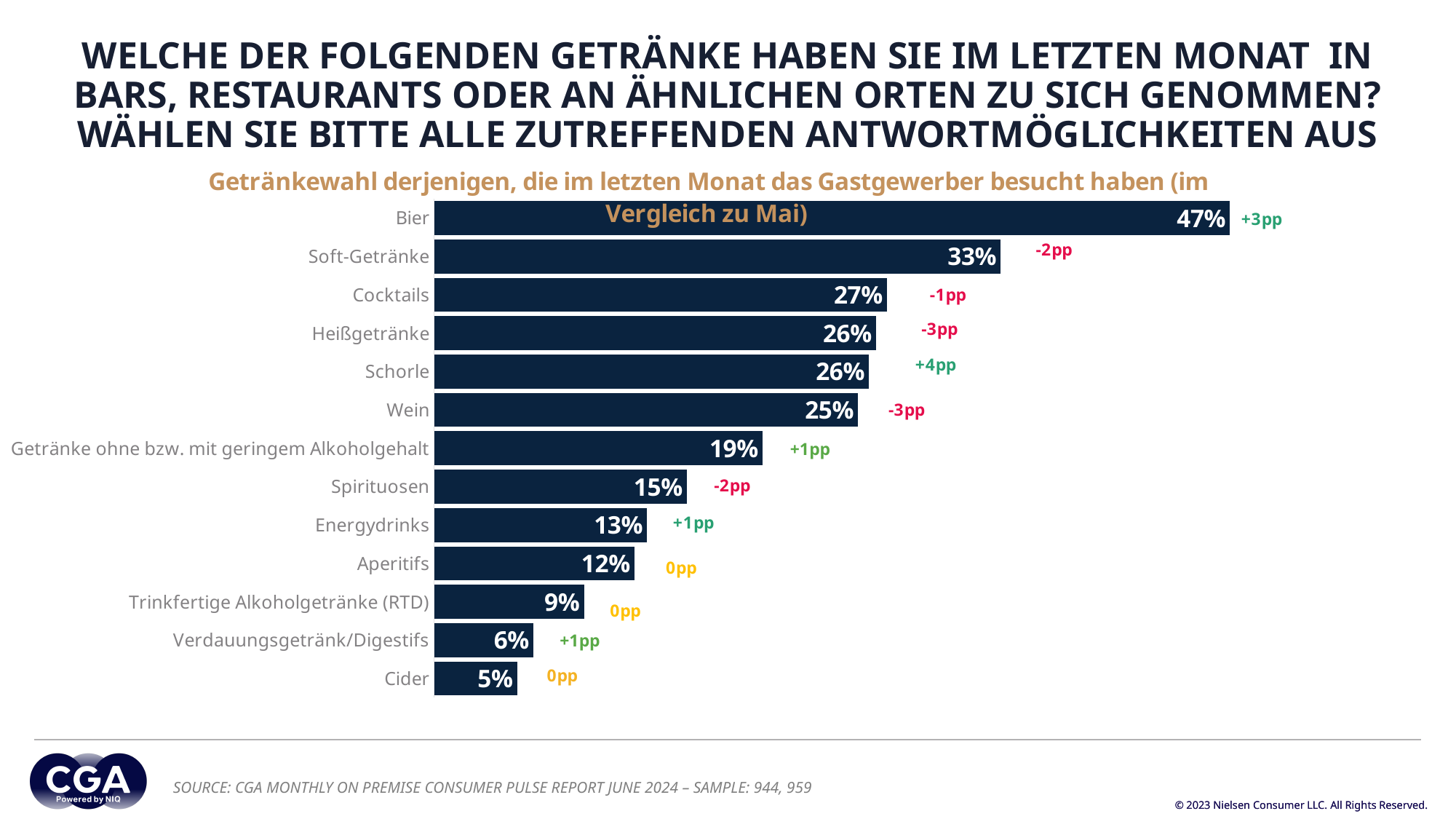
What is the change versus May (pp) shown next to Schorle? +4pp What is the difference between the values for Cocktails and Cider? 22% What is the value for Schorle? 26% How many categories are shown in the chart? 13 Which category has the lowest value? Cider What is the difference between the values for Bier and Soft-Getränke? 14% What is the change versus May (pp) shown next to Heißgetränke? -3pp Which category has the highest value? Bier What is the value for Spirituosen? 15% Which is larger, the value for Wein or the value for Energydrinks? Wein What kind of chart is shown on the slide? Bar chart What is the value for Bier? 47%